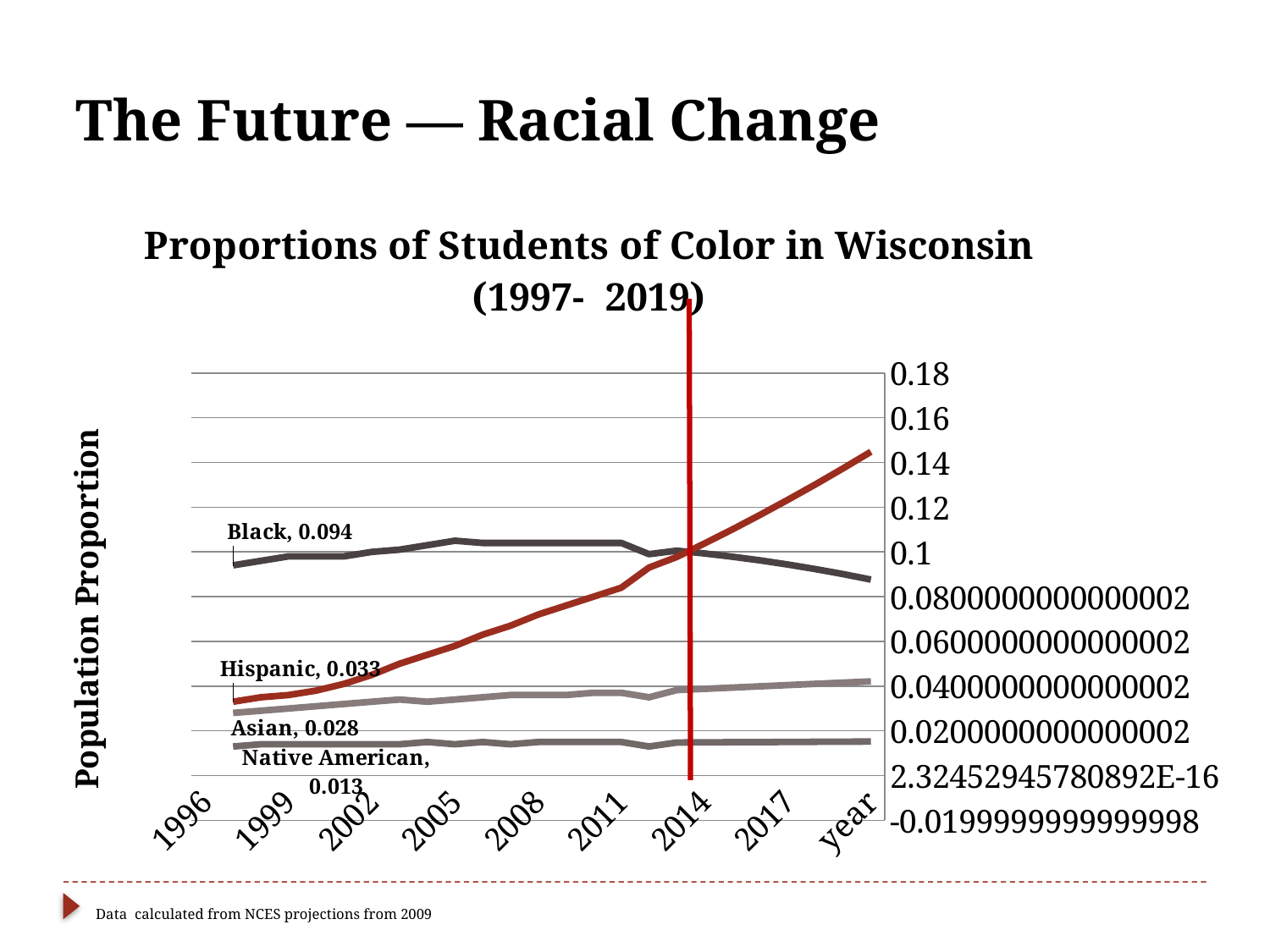
Which series has the lowest labelled starting value? Native American What is the labelled starting value for the Hispanic series? 0.033 What is the labelled starting value for the Black series? 0.094 What is the labelled starting value for the Native American series? 0.013 What is the labelled starting value for the Asian series? 0.028 What is the title of the vertical axis? Population Proportion Which labelled starting value is larger, Hispanic or Asian? Hispanic What kind of chart is shown on the slide? line chart What is the difference between the labelled starting values for Black and Hispanic? 0.061 Which series has the highest labelled starting value? Black Does the Hispanic line rise or fall from 1997 to 2019? rise